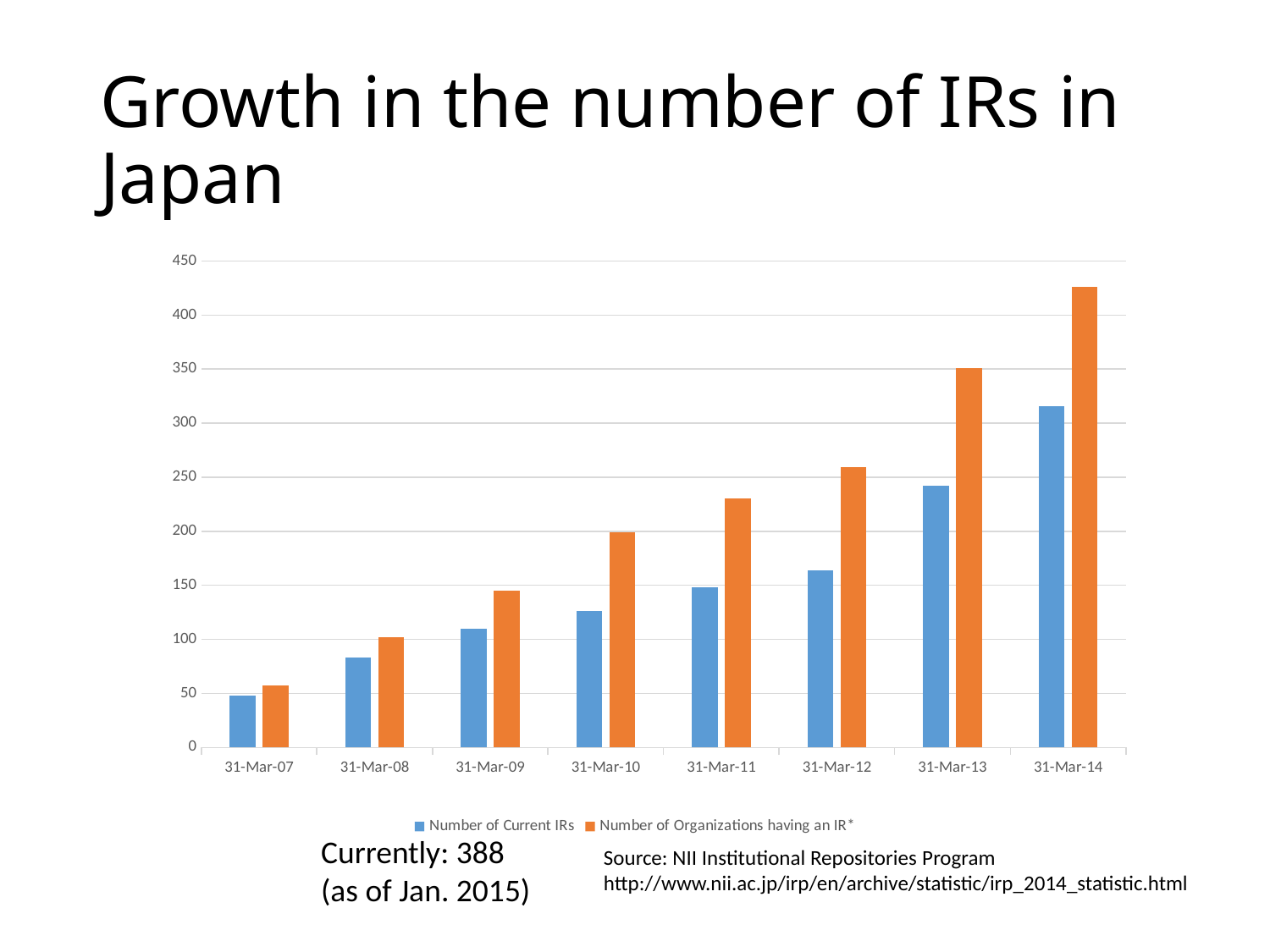
Is the value for Number of Current IRs at 31-Mar-12 greater or less than 200? less How many dates are shown on the x axis? 8 What kind of chart is shown on the slide? bar chart Which date has the lowest value for Number of Current IRs? 31-Mar-07 Is the value for Number of Current IRs at 31-Mar-14 greater or less than 300? greater What colour are the bars for Number of Organizations having an IR*? orange How many series does the legend list? 2 Is the value for Number of Organizations having an IR* at 31-Mar-11 greater or less than 200? greater Which date has the highest value for Number of Organizations having an IR*? 31-Mar-14 At 31-Mar-13, which is larger: Number of Current IRs or Number of Organizations having an IR*? Number of Organizations having an IR* Do the values for Number of Current IRs rise or fall from 31-Mar-07 to 31-Mar-14? rise